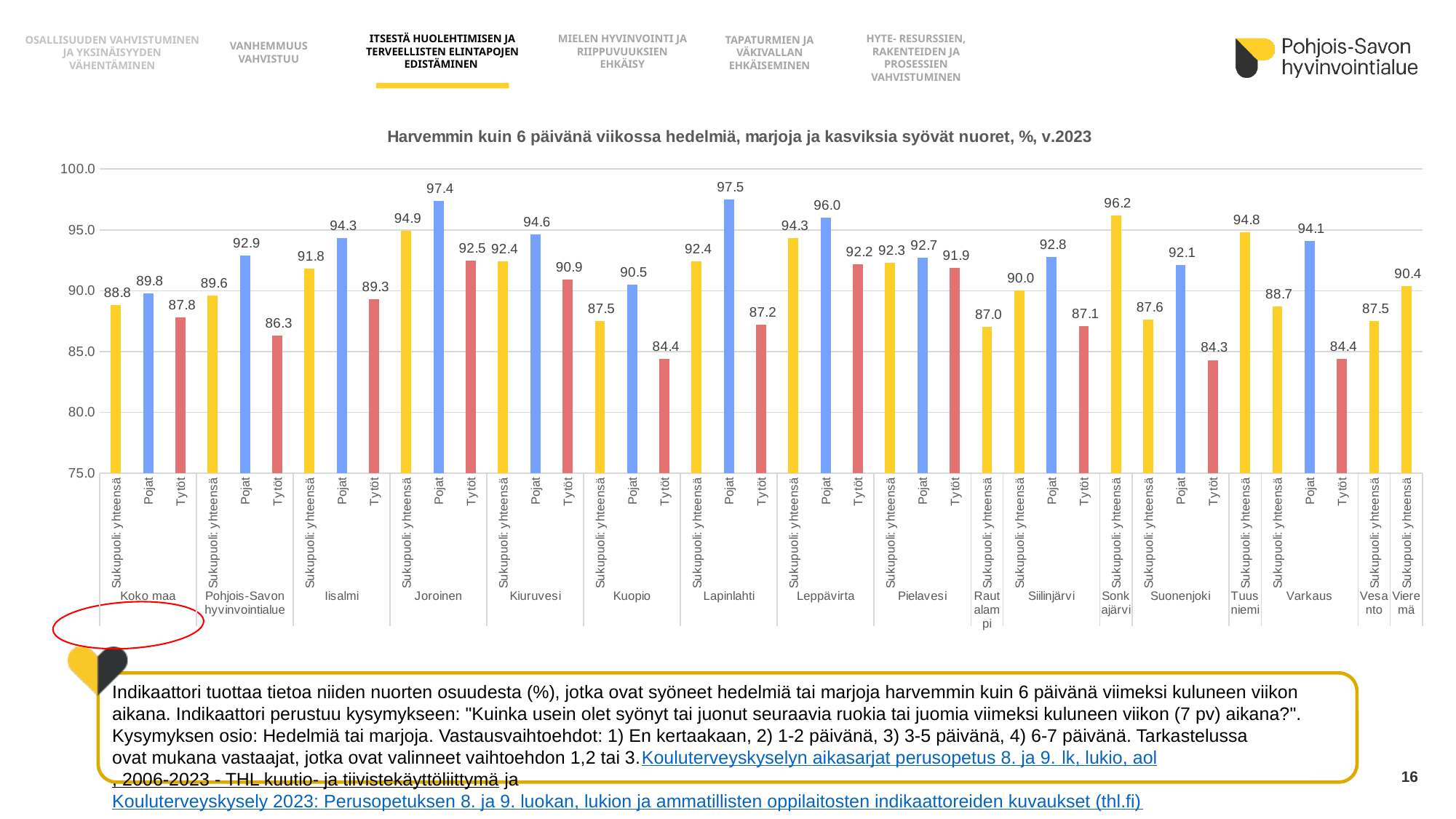
What is the value for Sukupuoli: yhteensä in Koko maa? 88.8 Is the value for Tytöt in Pohjois-Savon hyvinvointialue greater or less than 90.0? less How many municipality/area groups are shown on the x axis? 17 What is the value for Tytöt in Kuopio? 84.4 What is the value for Pojat in Joroinen? 97.4 What type of chart is shown on the slide? Bar chart What is the title of the chart? Harvemmin kuin 6 päivänä viikossa hedelmiä, marjoja ja kasviksia syövät nuoret, %, v.2023 Which is larger: the Pojat value in Leppävirta or the Pojat value in Iisalmi? Leppävirta (96.0) Which bar has the highest value on the chart? Pojat, Lapinlahti (97.5) What is the difference between the Pojat and Tytöt values in Varkaus? 9.7 What is the value for Sukupuoli: yhteensä in Sonkajärvi? 96.2 Which bar has the lowest value on the chart? Tytöt, Suonenjoki (84.3)